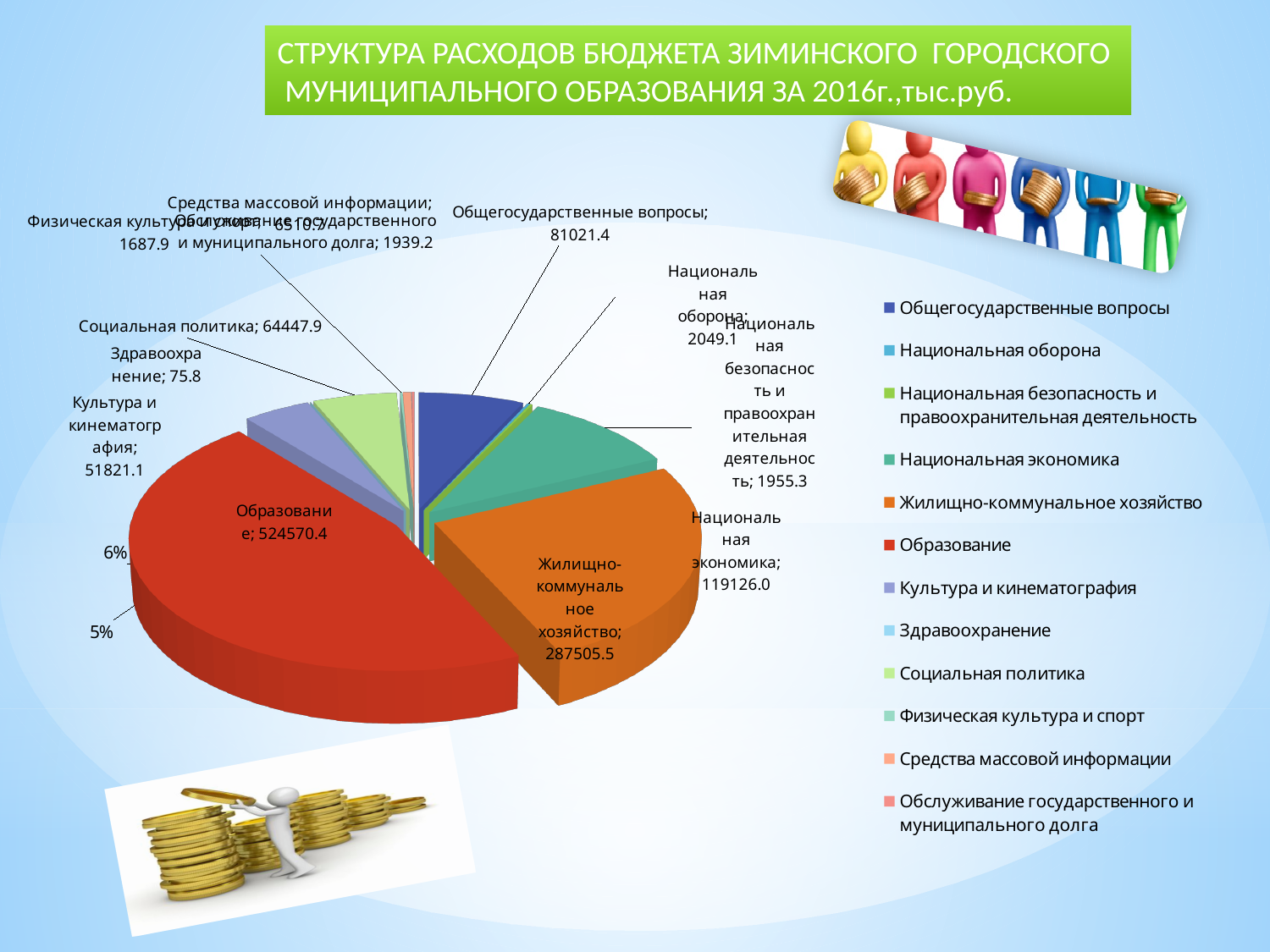
What is the value for Социальная политика? 64447.9 Which is larger, Национальная экономика or Общегосударственные вопросы? Национальная экономика What kind of chart is shown on the slide? pie chart What is the value for Здравоохранение? 75.8 What colour is the slice for Образование? red What is the value for Общегосударственные вопросы? 81021.4 What is the difference between the values for Образование and Жилищно-коммунальное хозяйство? 237064.9 How many categories does the legend of the pie chart list? 12 What is the value for Образование? 524570.4 What is the value for Жилищно-коммунальное хозяйство? 287505.5 What is the value for Национальная экономика? 119126.0 Which category has the largest slice of the pie? Образование